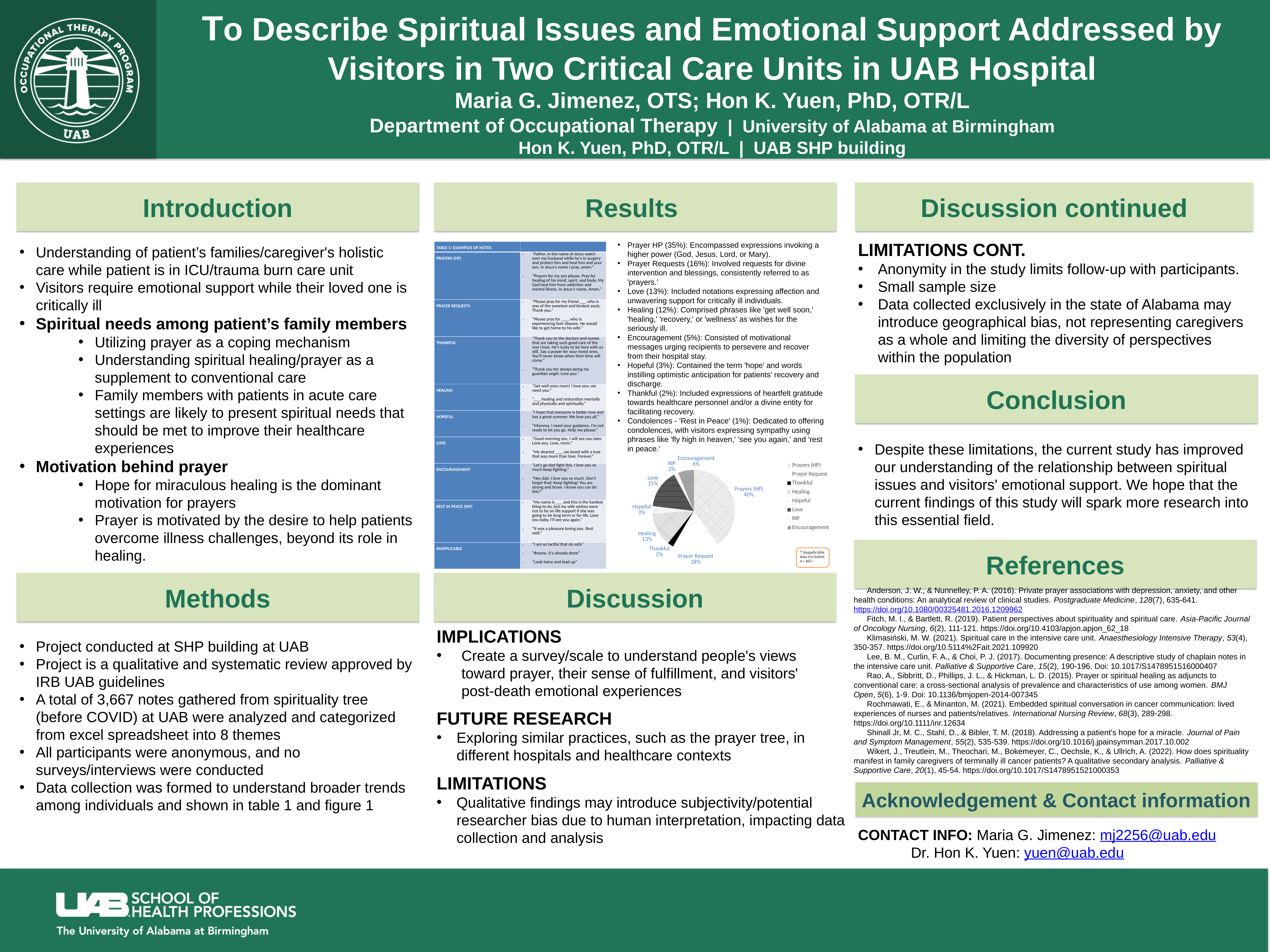
In the pie chart, what share is labelled for Hopeful? 3% In the pie chart, what share is labelled for Healing? 13% In the pie chart, what is the combined share of Thankful and RIP? 4% In the pie chart, what share is labelled for Prayers (HP)? 40% What kind of chart is shown in the Results section? pie chart In the pie chart, what share is labelled for Prayer Request? 18% Which category has the largest slice in the pie chart? Prayers (HP) How many categories does the legend of the pie chart list? 8 In the pie chart, what share is labelled for Love? 15% In the pie chart, which slice is larger, Love or Healing? Love In the pie chart, what share is labelled for Encouragement? 6% In the pie chart, what is the difference in percentage points between Prayers (HP) and Prayer Request? 22